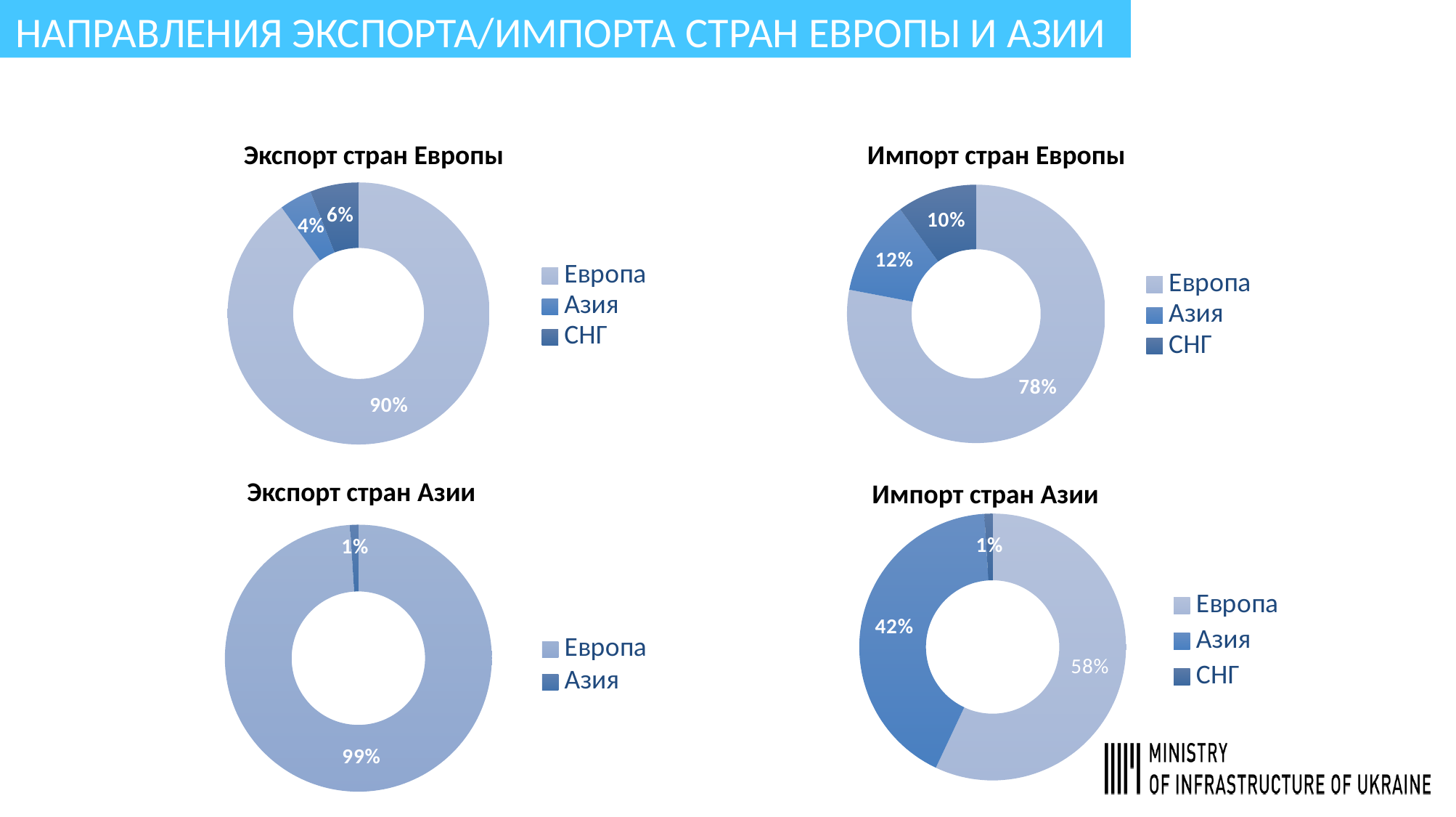
In the chart titled "Экспорт стран Европы", what share does СНГ have? 6% In the chart titled "Импорт стран Азии", which is larger, the share of Европа or the share of Азия? Европа In the chart titled "Импорт стран Азии", what is the difference between the shares of Европа and Азия? 16% In the chart titled "Импорт стран Европы", which category has the smallest share? СНГ How many categories does the legend of the chart titled "Экспорт стран Азии" list? 2 In the chart titled "Импорт стран Азии", what share does Азия have? 42% How many charts are shown on the slide? 4 In the chart titled "Экспорт стран Европы", what share does Европа have? 90% What kind of chart is the chart titled "Экспорт стран Европы"? Doughnut chart In the chart titled "Импорт стран Европы", what share does Азия have? 12% In the chart titled "Импорт стран Европы", what is the difference between the shares of Европа and Азия? 66% In the chart titled "Экспорт стран Азии", what share does Европа have? 99%